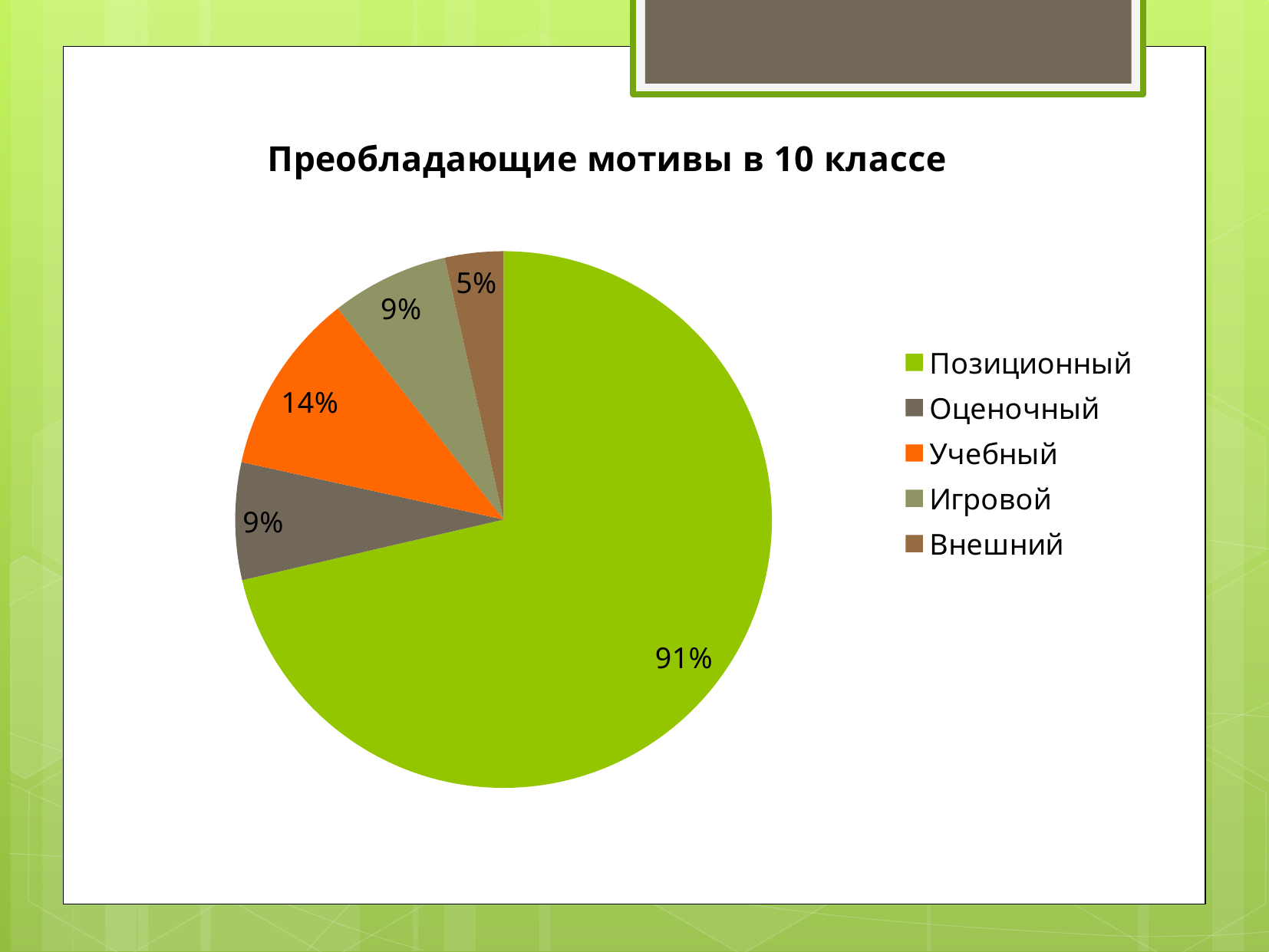
What is the title of the chart? Преобладающие мотивы в 10 классе What share of the pie does Игровой represent? 9% Which category has the smallest slice of the pie? Внешний What percentage is shown for Внешний? 5% What is the difference between the values for Позиционный and Учебный? 77 percentage points Which category has the largest slice of the pie? Позиционный What percentage is shown for Позиционный? 91% What percentage is shown for Учебный? 14% What percentage is shown for Оценочный? 9% What type of chart is shown on the slide? pie chart Which is larger, the value for Учебный or the value for Игровой? Учебный How many categories does the pie chart have? 5